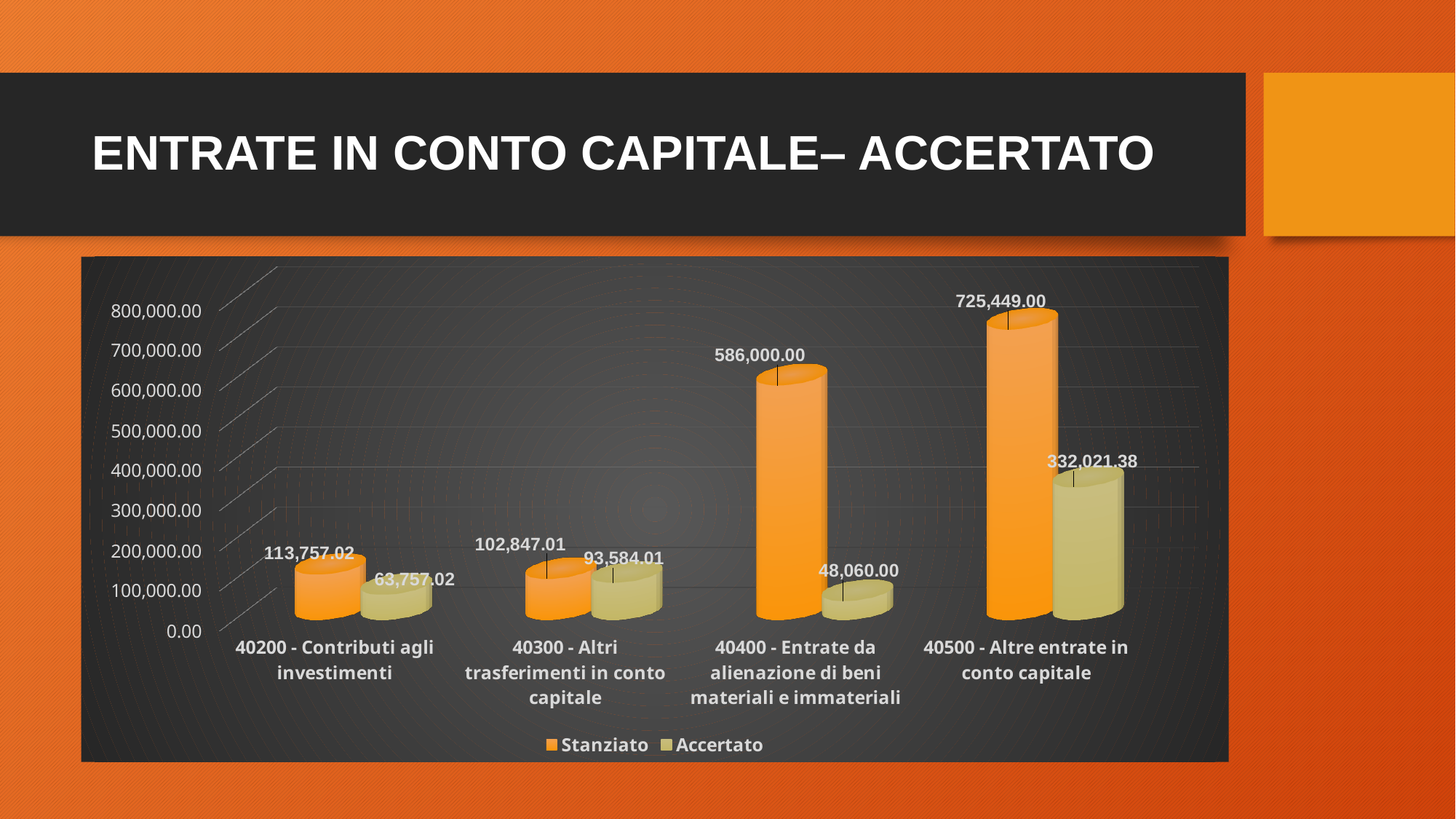
What is the difference between the Stanziato and Accertato values for 40200 - Contributi agli investimenti? 50,000.00 Which category has the lowest Accertato value? 40400 - Entrate da alienazione di beni materiali e immateriali What is the difference between the Stanziato and Accertato values for 40500 - Altre entrate in conto capitale? 393,427.62 What is the Accertato value for 40200 - Contributi agli investimenti? 63,757.02 Which is larger: the Accertato value for 40300 - Altri trasferimenti in conto capitale or the Accertato value for 40200 - Contributi agli investimenti? 40300 - Altri trasferimenti in conto capitale How many series does the legend list? 2 What is the Stanziato value for 40500 - Altre entrate in conto capitale? 725,449.00 What kind of chart is shown on the slide? Bar chart How many categories are shown on the x axis? 4 What is the Accertato value for 40400 - Entrate da alienazione di beni materiali e immateriali? 48,060.00 Which category has the highest Stanziato value? 40500 - Altre entrate in conto capitale What is the Stanziato value for 40300 - Altri trasferimenti in conto capitale? 102,847.01